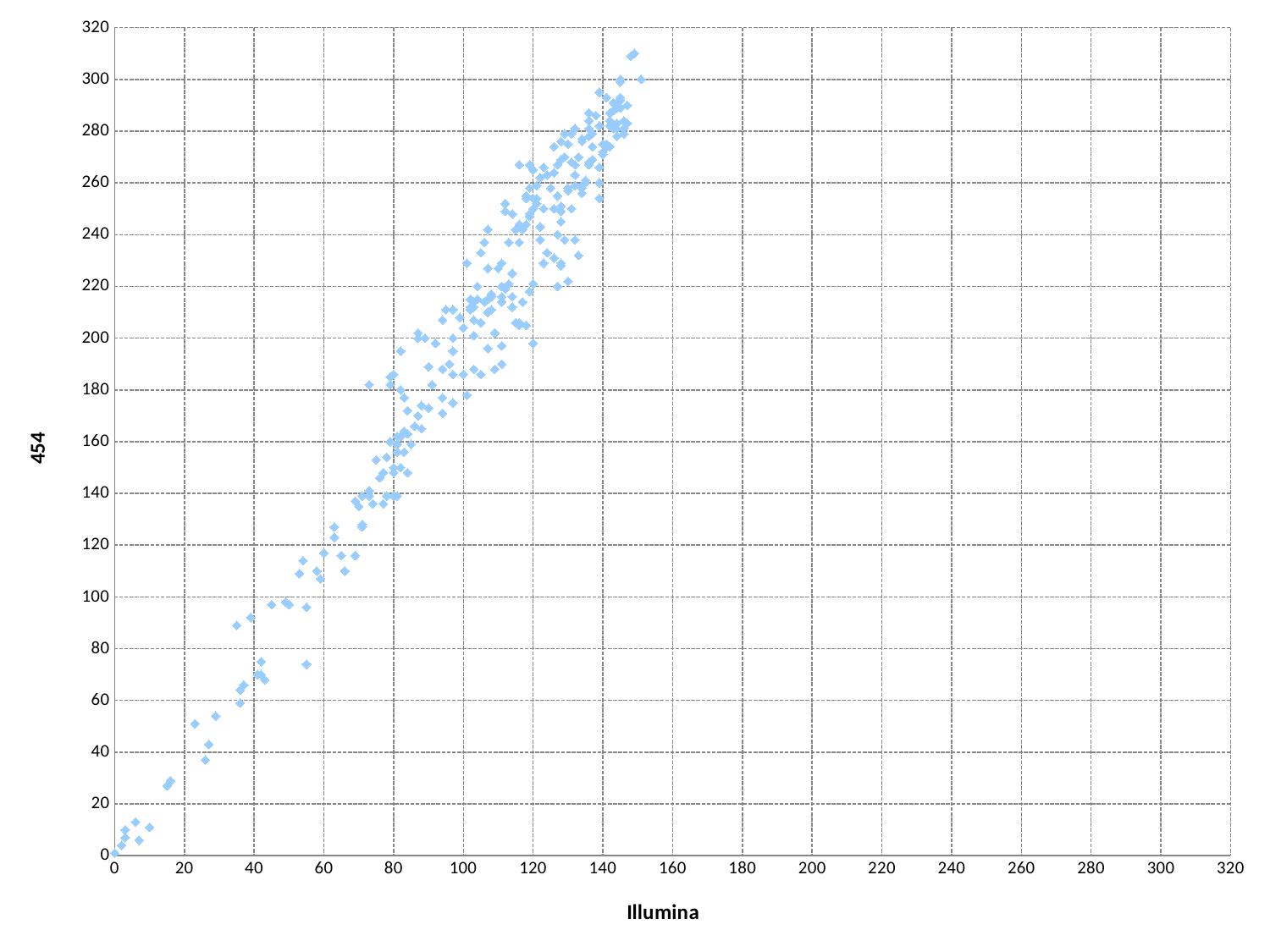
What is the label of the x axis? Illumina What kind of chart is shown on the slide? scatter plot What is the maximum value shown on the x axis? 320 Is the largest Illumina value plotted greater or less than 140? greater Are any points plotted with an Illumina value greater than 200? no Is the largest Illumina value plotted greater or less than 160? less Do the 454 values generally rise or fall as the Illumina values increase along the x axis? rise What is the label of the y axis? 454